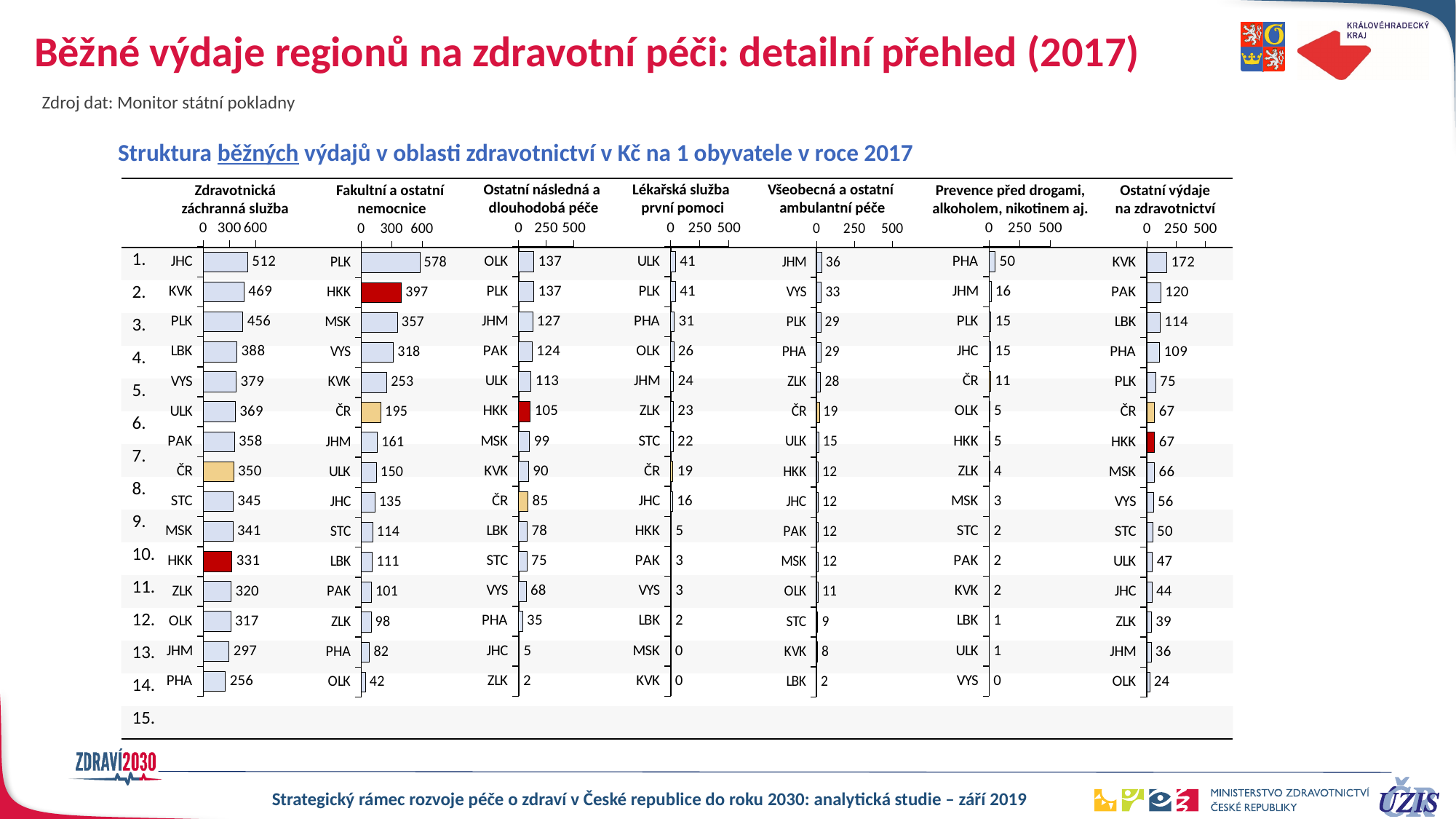
How many regions are listed in the 'Zdravotnická záchranná služba' chart? 15 What type of chart is used for 'Zdravotnická záchranná služba'? Bar chart In the 'Ostatní výdaje na zdravotnictví' chart, what is the value for KVK? 172 In the 'Ostatní následná a dlouhodobá péče' chart, which region has the lowest value? ZLK In the 'Všeobecná a ostatní ambulantní péče' chart, which is larger, the value for JHM or the value for VYS? JHM In the 'Zdravotnická záchranná služba' chart, what is the value for JHC? 512 In the 'Lékařská služba první pomoci' chart, what is the difference between the values for ULK and PHA? 10 In the 'Fakultní a ostatní nemocnice' chart, what is the value for HKK? 397 In the 'Prevence před drogami, alkoholem, nikotinem aj.' chart, what is the value for PHA? 50 In the 'Ostatní výdaje na zdravotnictví' chart, what is the difference between the values for KVK and PAK? 52 In the 'Fakultní a ostatní nemocnice' chart, which region has the highest value? PLK In the 'Zdravotnická záchranná služba' chart, is the value for PHA greater or less than 300? less